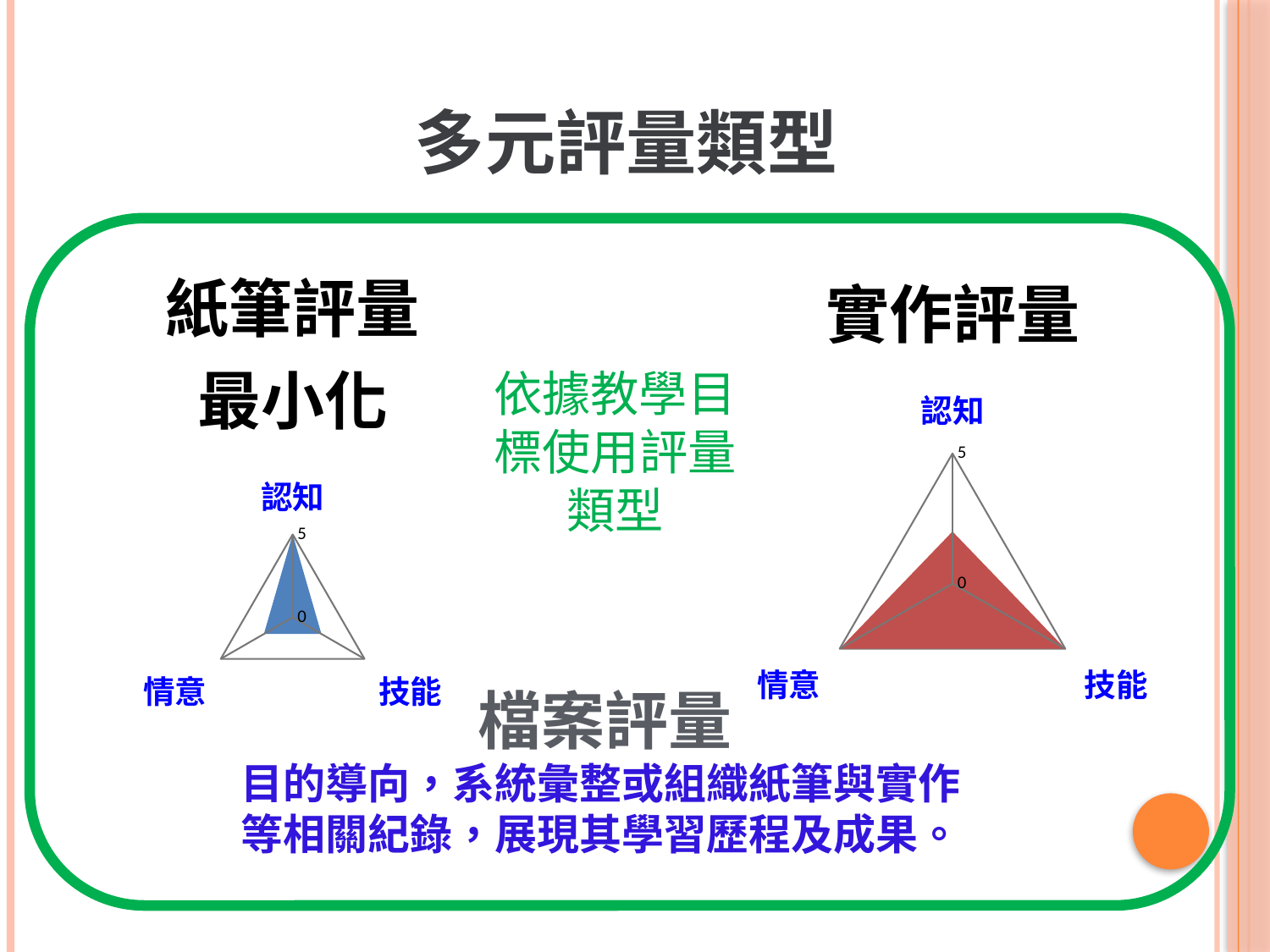
In the left chart (紙筆評量), which category has the highest value? 認知 In the right chart (實作評量), how many categories are plotted on the axes? 3 In the right chart (實作評量), which category has the lowest value? 認知 In the right chart (實作評量), what is the value for 情意? 5 In the left chart (紙筆評量), how many categories are plotted on the axes? 3 In the left chart (紙筆評量), is the value for 技能 greater or less than 5? less In the right chart (實作評量), what is the value for 技能? 5 What kind of chart is shown under the heading 紙筆評量 on the left of the slide? radar chart What kind of chart is shown under the heading 實作評量 on the right of the slide? radar chart In the left chart (紙筆評量), what is the value for 認知? 5 In the right chart (實作評量), which is larger, the value for 技能 or the value for 認知? 技能 What are the three axis labels shared by both radar charts on the slide? 認知, 情意, 技能